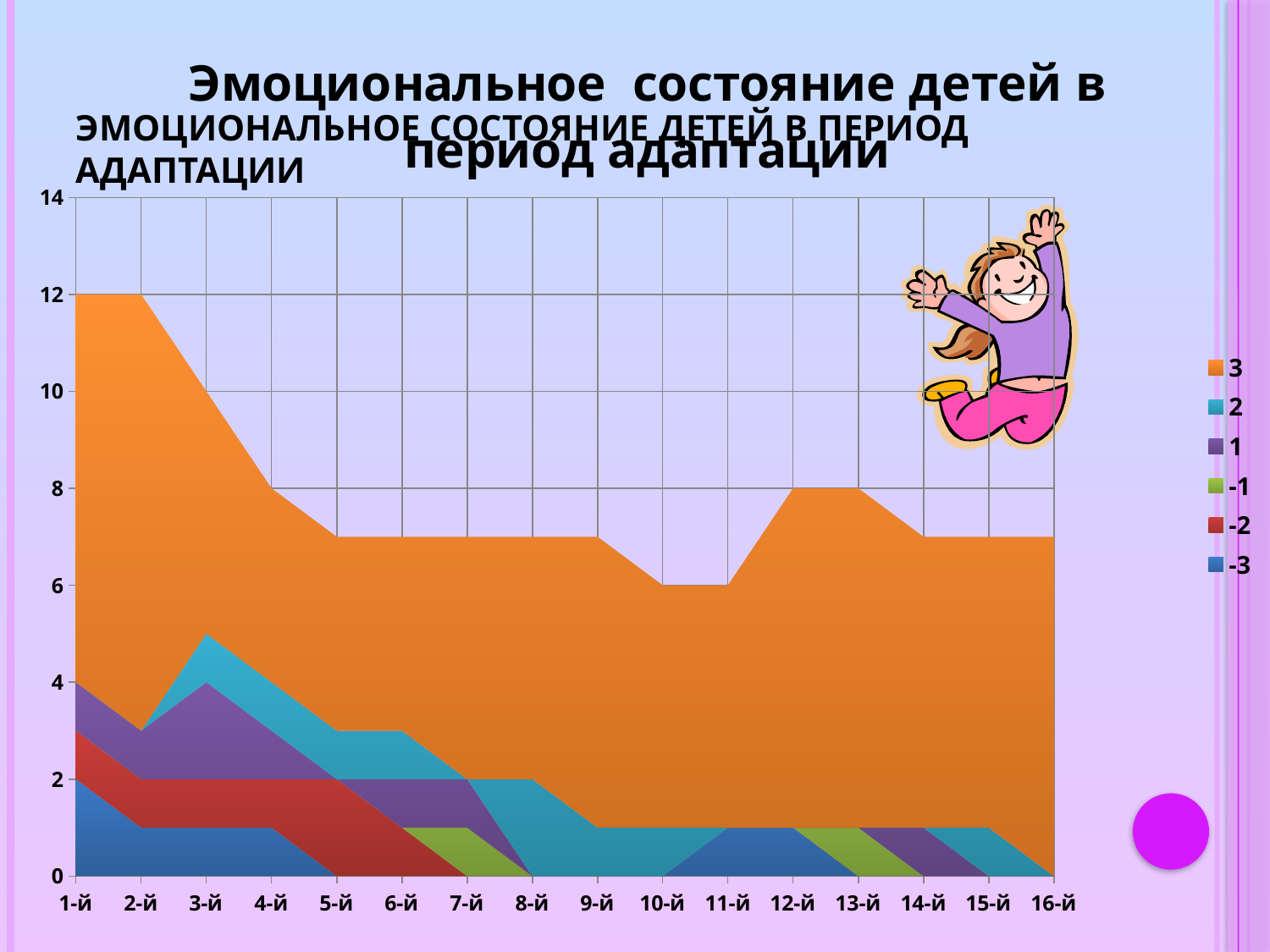
How many categories are shown along the x axis of the chart? 16 How many series does the chart legend list? 6 Does the total stacked value rise or fall from 1-й to 5-й? fall What are the entries listed in the chart legend? 3, 2, 1, -1, -2, -3 Is the total stacked value at 12-й greater or less than 6? greater Which has the larger total stacked value, 1-й or 16-й? 1-й Is the total stacked value at 5-й greater or less than 8? less Which colour represents the series "3" in the chart? orange What is the total stacked value at 10-й? 6 What kind of chart is shown on the slide? area chart What is the total stacked value at 1-й? 12 What is the total stacked value at 4-й? 8